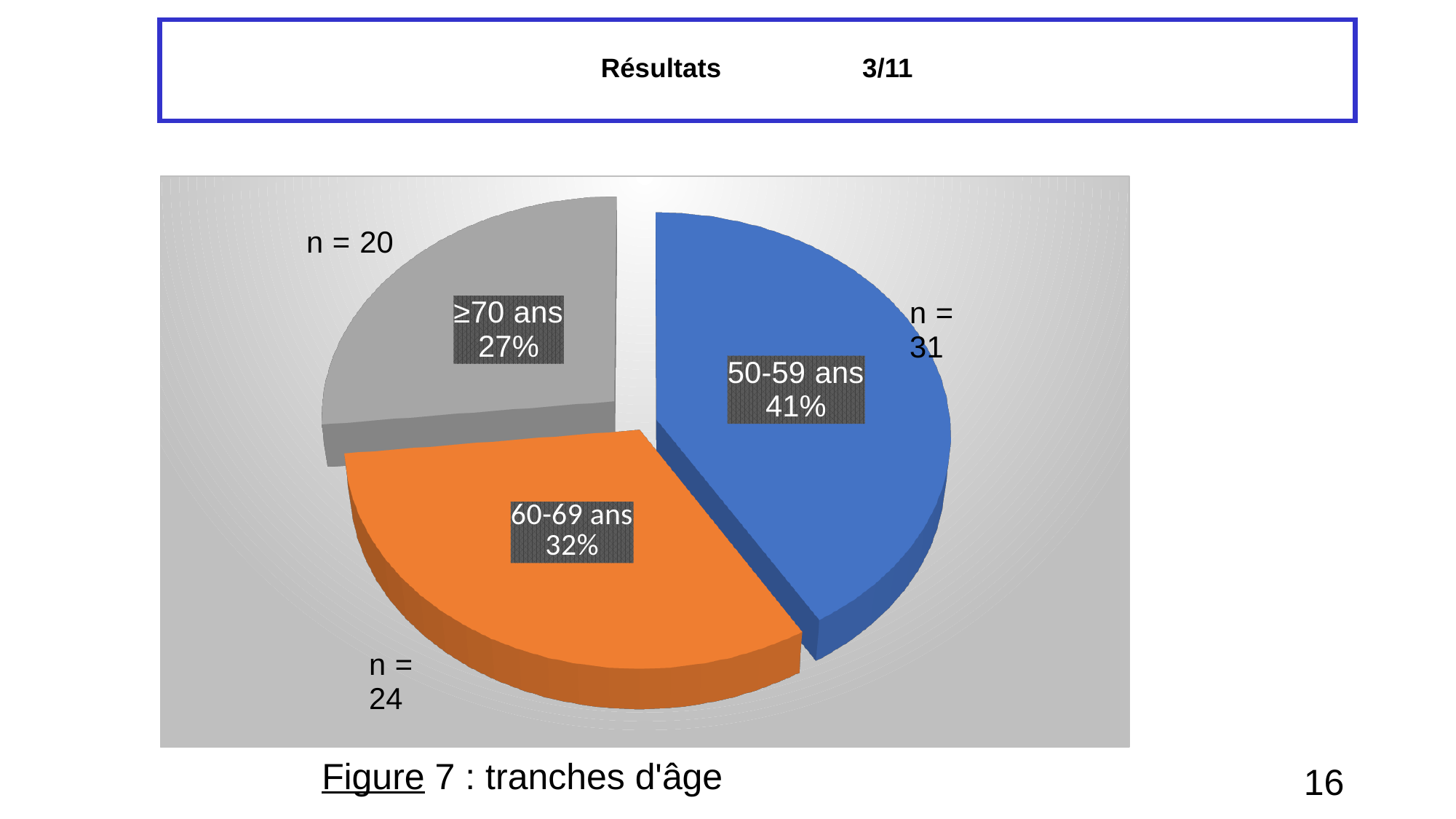
What kind of chart is shown on the slide? pie chart What percentage share does the ≥70 ans slice have? 27% What is the n value for the 60-69 ans category? n = 24 What is the caption of the figure below the chart? Figure 7 : tranches d'âge Which age group has the smallest share of the pie? ≥70 ans What is the n value for the 50-59 ans category? n = 31 Which age group has the largest share of the pie? 50-59 ans What is the difference in n between the 50-59 ans and ≥70 ans categories? 11 How many slices does the pie chart have? 3 What percentage share does the 50-59 ans slice have? 41% What is the n value for the ≥70 ans category? n = 20 What percentage share does the 60-69 ans slice have? 32%